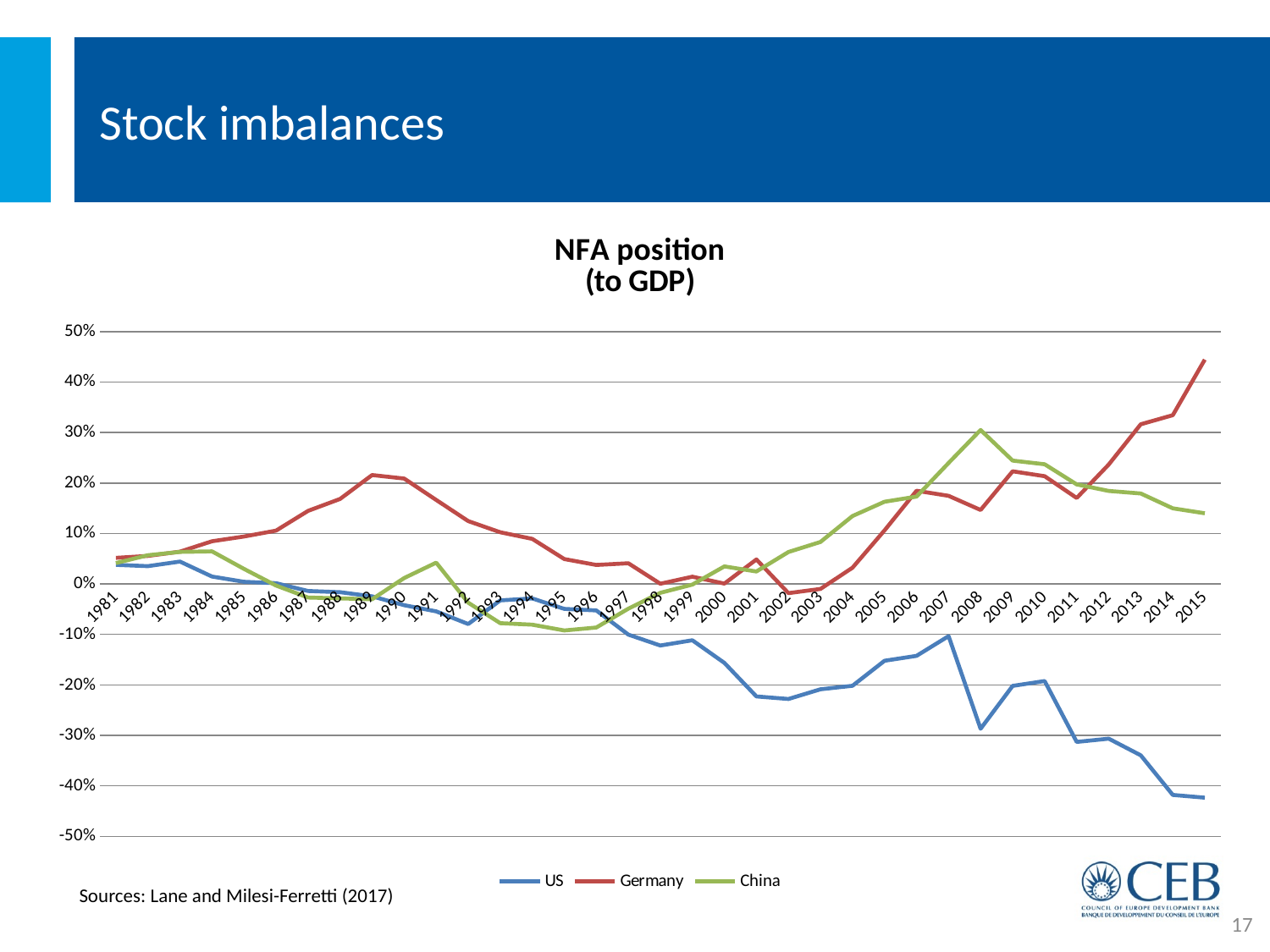
What is the title of the chart? NFA position (to GDP) Is the value for China in 2008 greater or less than 20%? greater What kind of chart is shown on the slide? line chart Which series are listed in the legend? US, Germany, China How many series does the legend list? 3 Which series has the highest value in 2008? China Does the US series rise or fall from 2007 to 2015? fall Is the value for the US in 2015 greater or less than -40%? less Which series has the lowest value in 2015? US In 2015, which series has the larger value, Germany or China? Germany How many years are plotted along the x axis? 35 Is the value for Germany in 2015 greater or less than 40%? greater